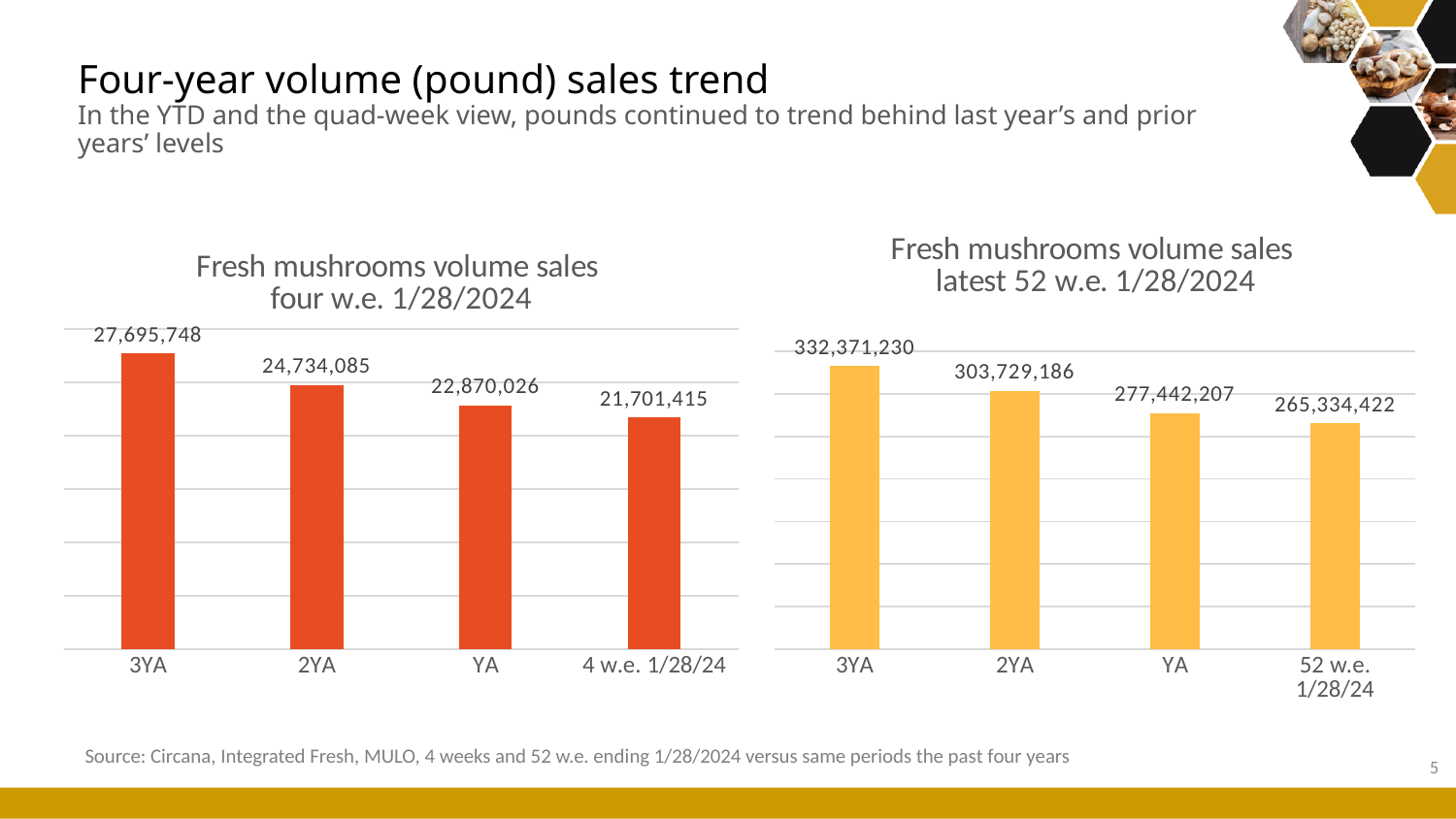
In the 'Fresh mushrooms volume sales latest 52 w.e. 1/28/2024' chart, do the values rise or fall from 3YA to 52 w.e. 1/28/24? Fall In the 'Fresh mushrooms volume sales latest 52 w.e. 1/28/2024' chart, what is the value for 52 w.e. 1/28/24? 265,334,422 How many categories are shown in the 'Fresh mushrooms volume sales latest 52 w.e. 1/28/2024' chart? 4 In the 'Fresh mushrooms volume sales latest 52 w.e. 1/28/2024' chart, what is the difference between the YA value and the 52 w.e. 1/28/24 value? 12,107,785 What kind of chart is the 'Fresh mushrooms volume sales four w.e. 1/28/2024' chart? Bar chart In the 'Fresh mushrooms volume sales four w.e. 1/28/2024' chart, what is the difference between the 3YA value and the 4 w.e. 1/28/24 value? 5,994,333 In the 'Fresh mushrooms volume sales latest 52 w.e. 1/28/2024' chart, which category has the lowest value? 52 w.e. 1/28/24 In the 'Fresh mushrooms volume sales latest 52 w.e. 1/28/2024' chart, what is the value for 2YA? 303,729,186 In the 'Fresh mushrooms volume sales four w.e. 1/28/2024' chart, what is the value for 4 w.e. 1/28/24? 21,701,415 In the 'Fresh mushrooms volume sales four w.e. 1/28/2024' chart, which category has the highest value? 3YA In the 'Fresh mushrooms volume sales four w.e. 1/28/2024' chart, what is the value for 3YA? 27,695,748 In the 'Fresh mushrooms volume sales four w.e. 1/28/2024' chart, which is larger, the value for 2YA or the value for YA? 2YA